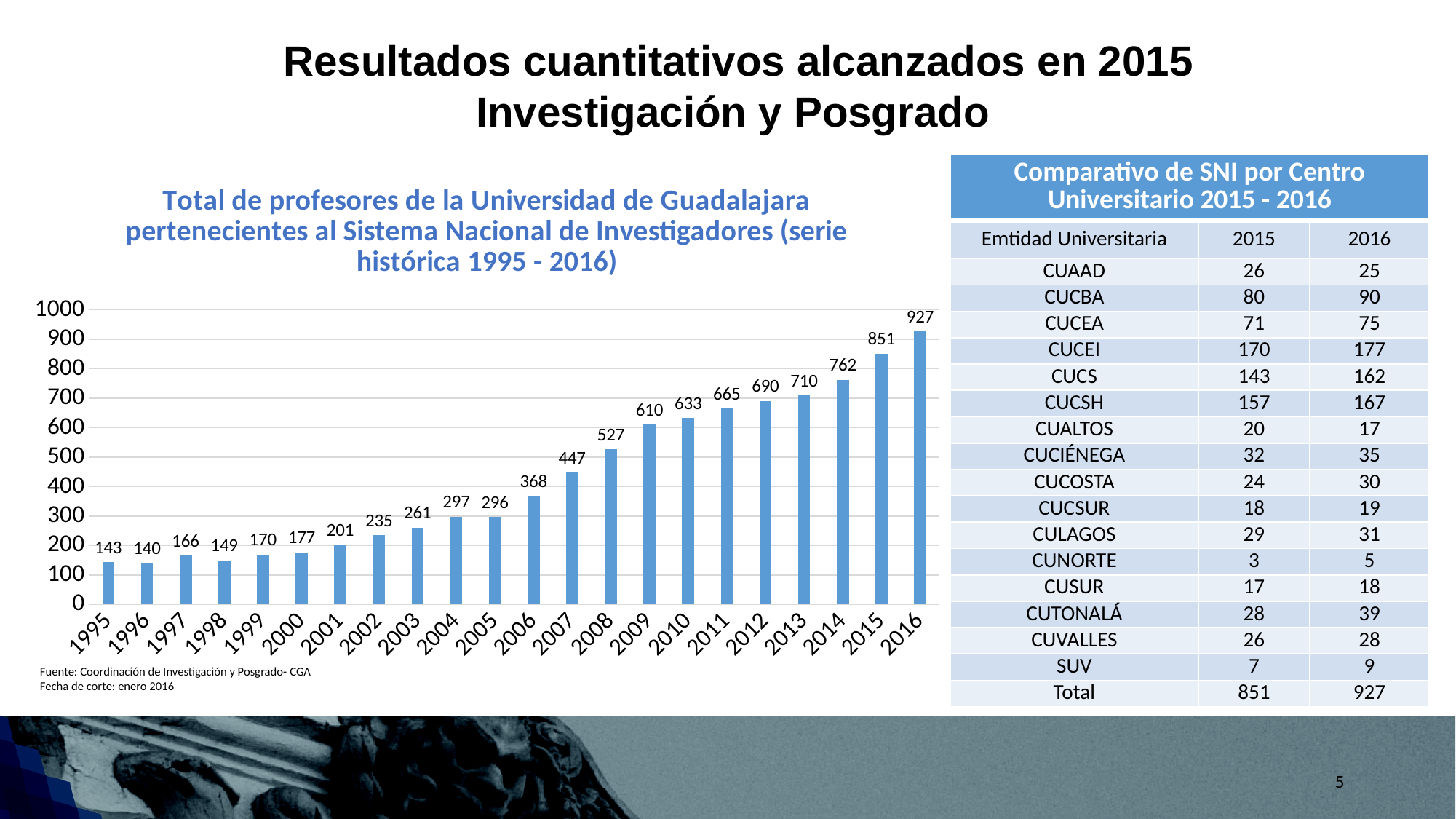
What is the value for 2008 in the bar chart? 527 Which year has the lowest value in the bar chart? 1996 What is the value for 1995 in the bar chart? 143 Do the values in the bar chart generally rise or fall from 1995 to 2016? Rise What is the difference between the values for 2016 and 2015 in the bar chart? 76 Which is larger in the bar chart, the value for 2004 or the value for 2005? 2004 Which year has the highest value in the bar chart? 2016 What is the title of the bar chart? Total de profesores de la Universidad de Guadalajara pertenecientes al Sistema Nacional de Investigadores (serie histórica 1995 - 2016) How many years are shown on the x axis of the bar chart? 22 What is the value for 2016 in the bar chart? 927 Is the value for 2007 in the bar chart greater or less than 400? greater What kind of chart is shown on the slide? Bar chart